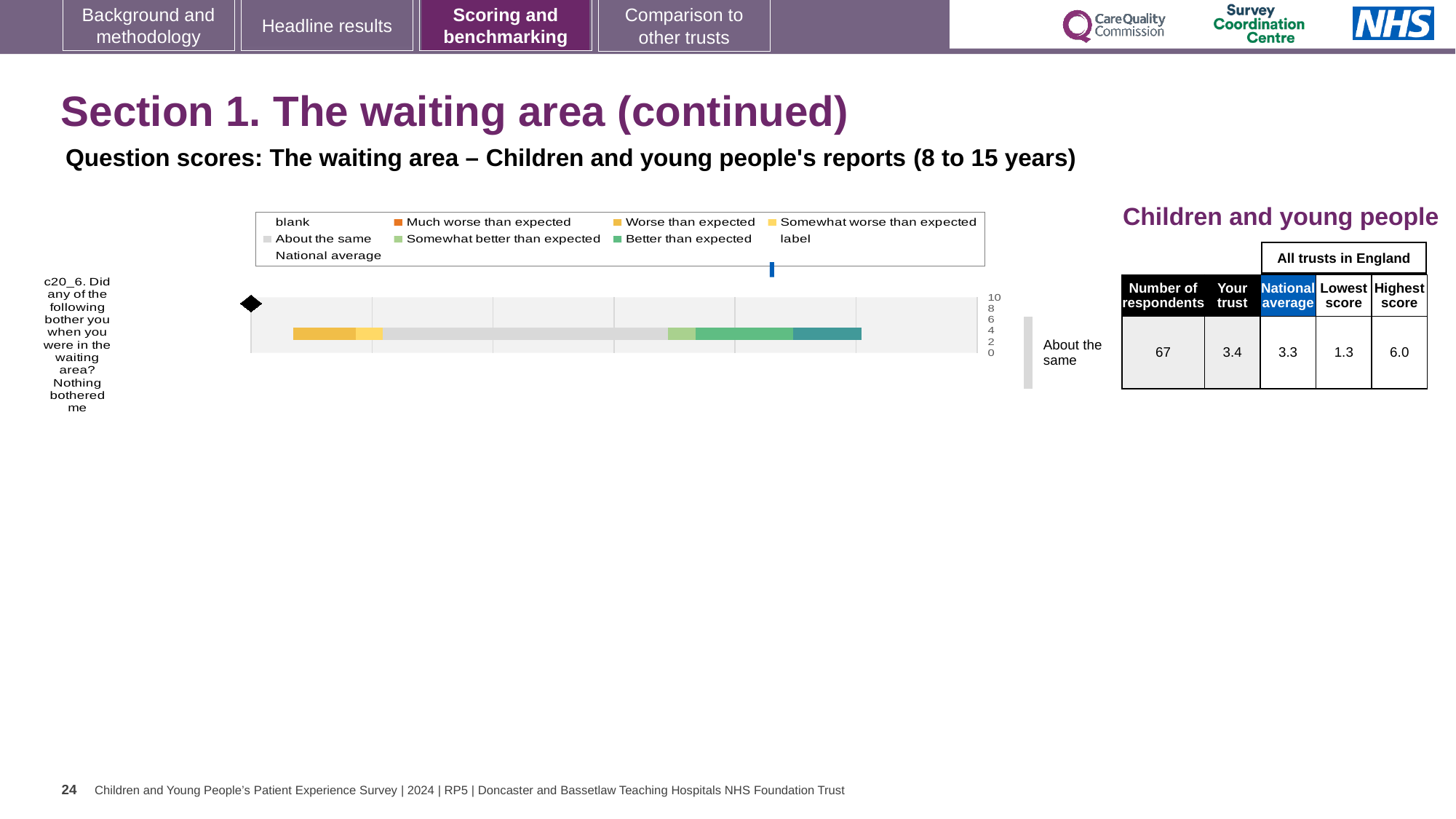
How many question categories are plotted in the chart? 1 In the table next to the chart, what is the 'Your trust' score for c20_6? 3.4 What is the highest value shown on the chart's axis? 10 What kind of chart is shown on the slide? bar chart In the table next to the chart, which is larger for c20_6: the 'Your trust' score or the national average? Your trust In the table next to the chart, what is the national average score for c20_6? 3.3 What label is printed to the right of the chart describing the trust's result for c20_6? About the same Which legend entry is shown in orange? Much worse than expected In the table next to the chart, what is the number of respondents for c20_6? 67 In the table next to the chart, what is the difference between the highest score and the lowest score for c20_6? 4.7 In the table next to the chart, what is the highest score across all trusts in England for c20_6? 6.0 How many entries does the chart's legend list? 9